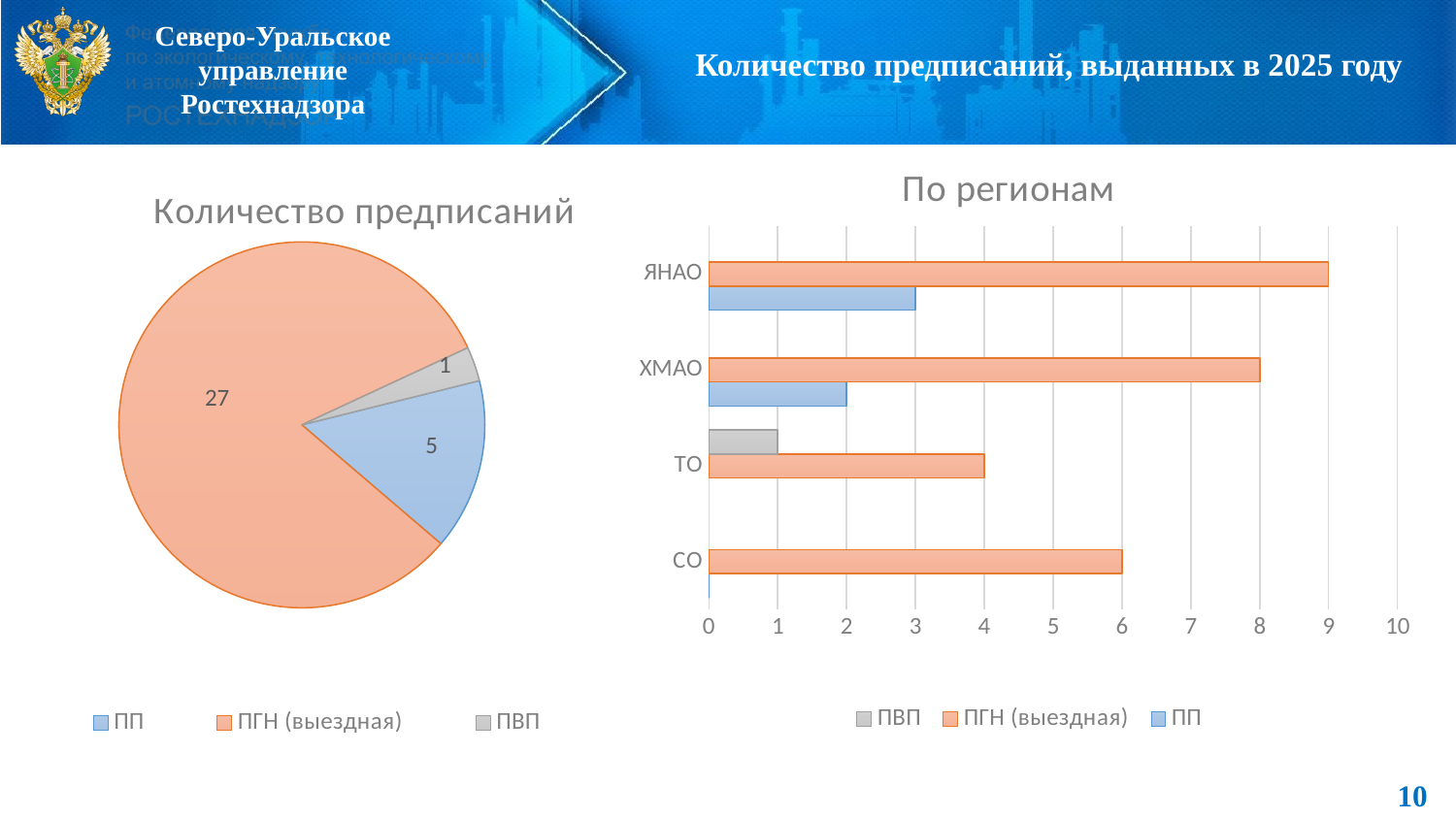
In the pie chart 'Количество предписаний', how many slices are there? 3 In the chart 'По регионам', which region has the highest ПГН (выездная) value? ЯНАО In the pie chart 'Количество предписаний', what is the value for ПП? 5 In the pie chart 'Количество предписаний', which category has the smallest slice? ПВП In the chart 'По регионам', what is the value of ПГН (выездная) for ЯНАО? 9 In the chart 'По регионам', what is the value of ПП for ХМАО? 2 In the pie chart 'Количество предписаний', what is the value for ПГН (выездная)? 27 What kind of chart is the chart on the left of the slide? Pie chart In the chart 'По регионам', is the ПГН (выездная) value for СО greater or less than 5? greater What kind of chart is the chart 'По регионам'? Bar chart In the pie chart 'Количество предписаний', what is the difference between the ПГН (выездная) value and the ПП value? 22 In the chart 'По регионам', how many series does the legend list? 3